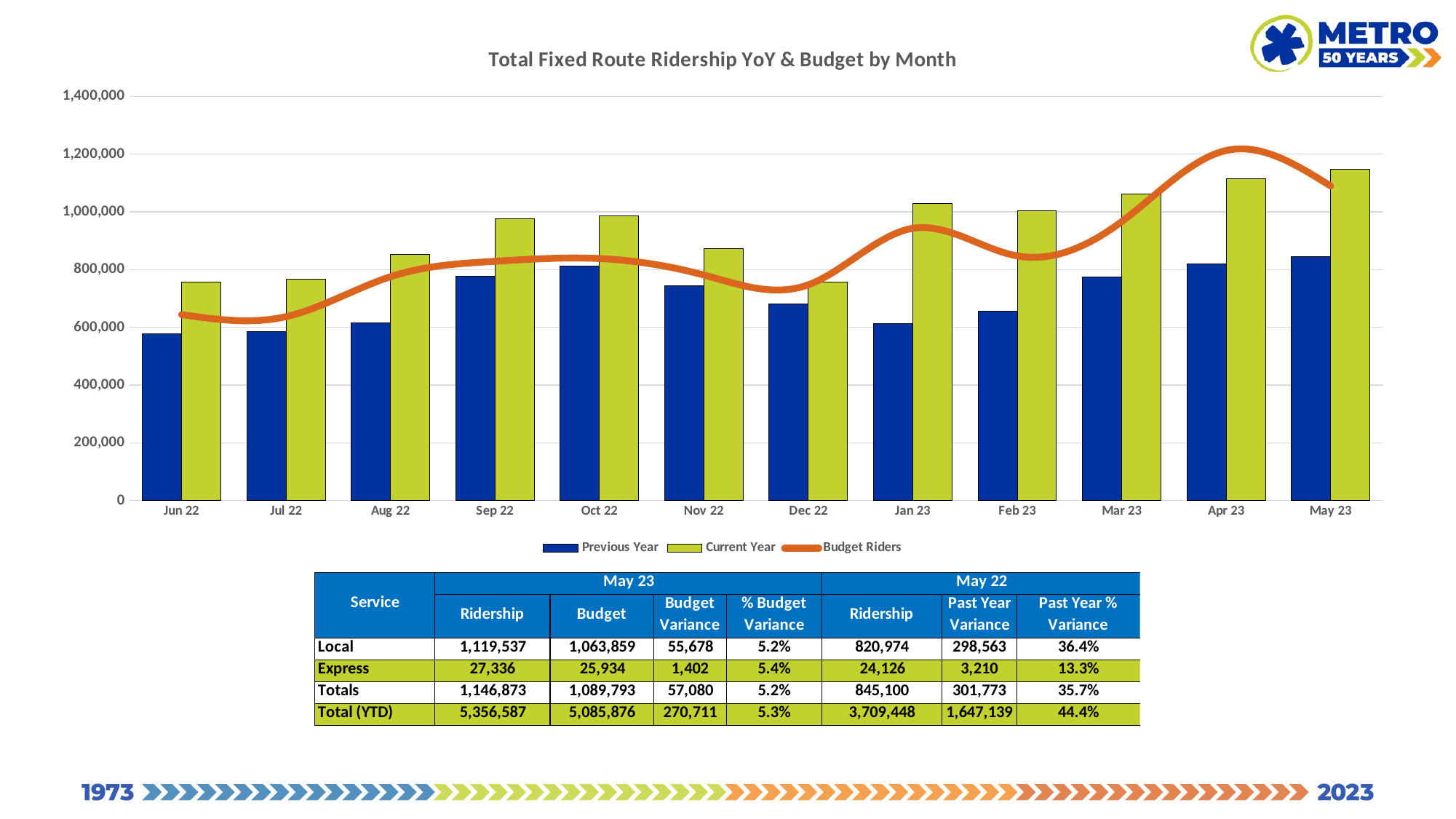
Which is larger: the Current Year value for Oct 22 or the Current Year value for Nov 22? Oct 22 Do the Current Year values rise or fall from Jan 23 to May 23? rise How many series does the chart legend list? 3 Which is larger for Mar 23: the Previous Year bar or the Current Year bar? Current Year Which month has the highest Current Year bar? May 23 Is the Previous Year value for Dec 22 greater or less than 800,000? less Which series in the chart is drawn as an orange line rather than bars? Budget Riders Is the Current Year value for May 23 greater or less than 1,000,000? greater Is the Current Year value for Sep 22 greater or less than 1,000,000? less How many months are shown on the x axis of the chart? 12 What is the title of the chart? Total Fixed Route Ridership YoY & Budget by Month